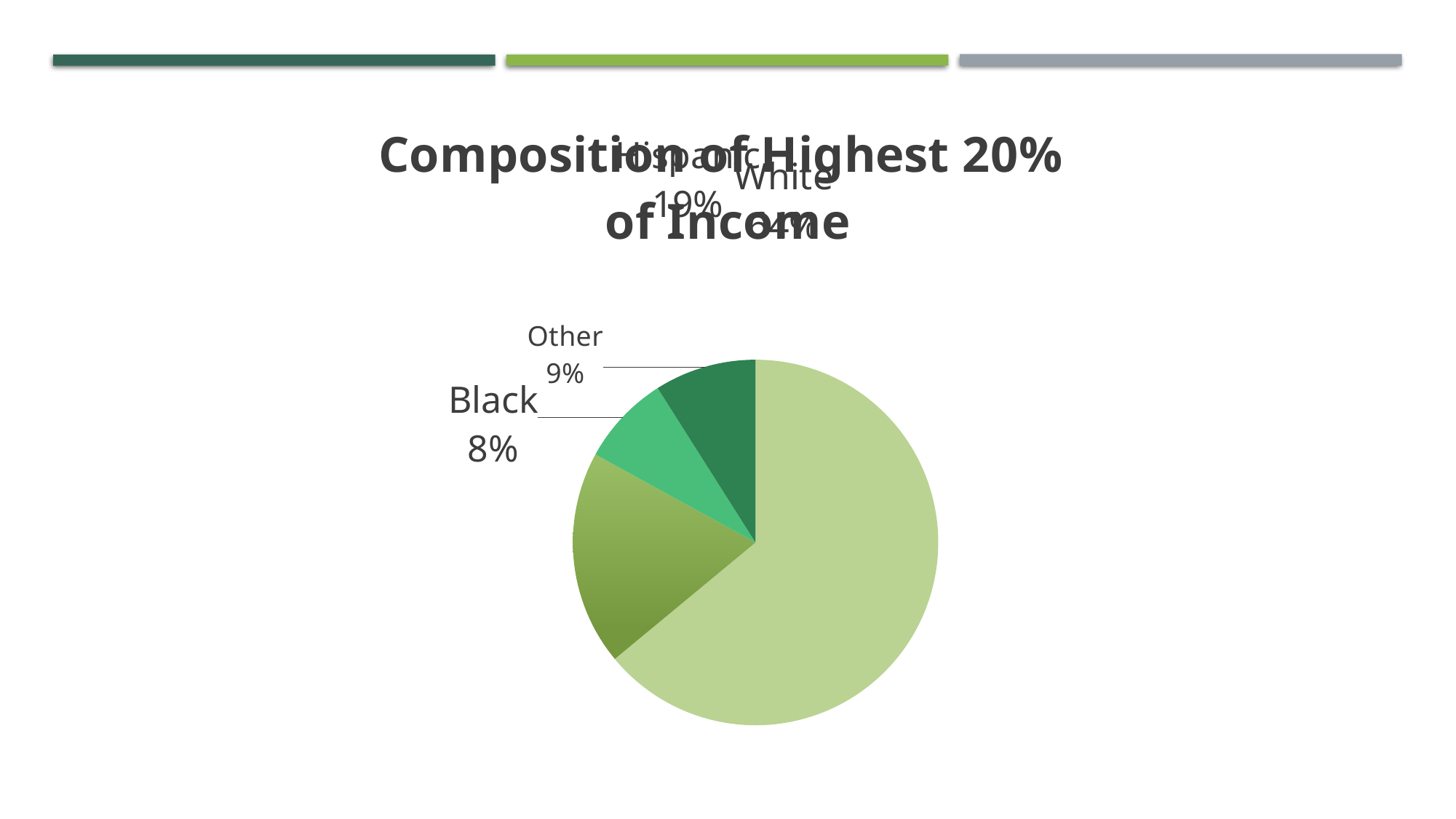
What share of the pie does the Black slice represent? 8% Which slice is larger, Hispanic or Other? Hispanic Which category has the smallest slice of the pie? Black Which category has the largest slice of the pie? White What is the title of the chart? Composition of Highest 20% of Income What is the difference between the Other share and the Black share? 1% What is the difference between the Hispanic share and the Other share? 10% Which slice is larger, Other or Black? Other What kind of chart is shown on the slide? pie chart What share of the pie does the Hispanic slice represent? 19% How many slices does the pie chart have? 4 What share of the pie does the Other slice represent? 9%